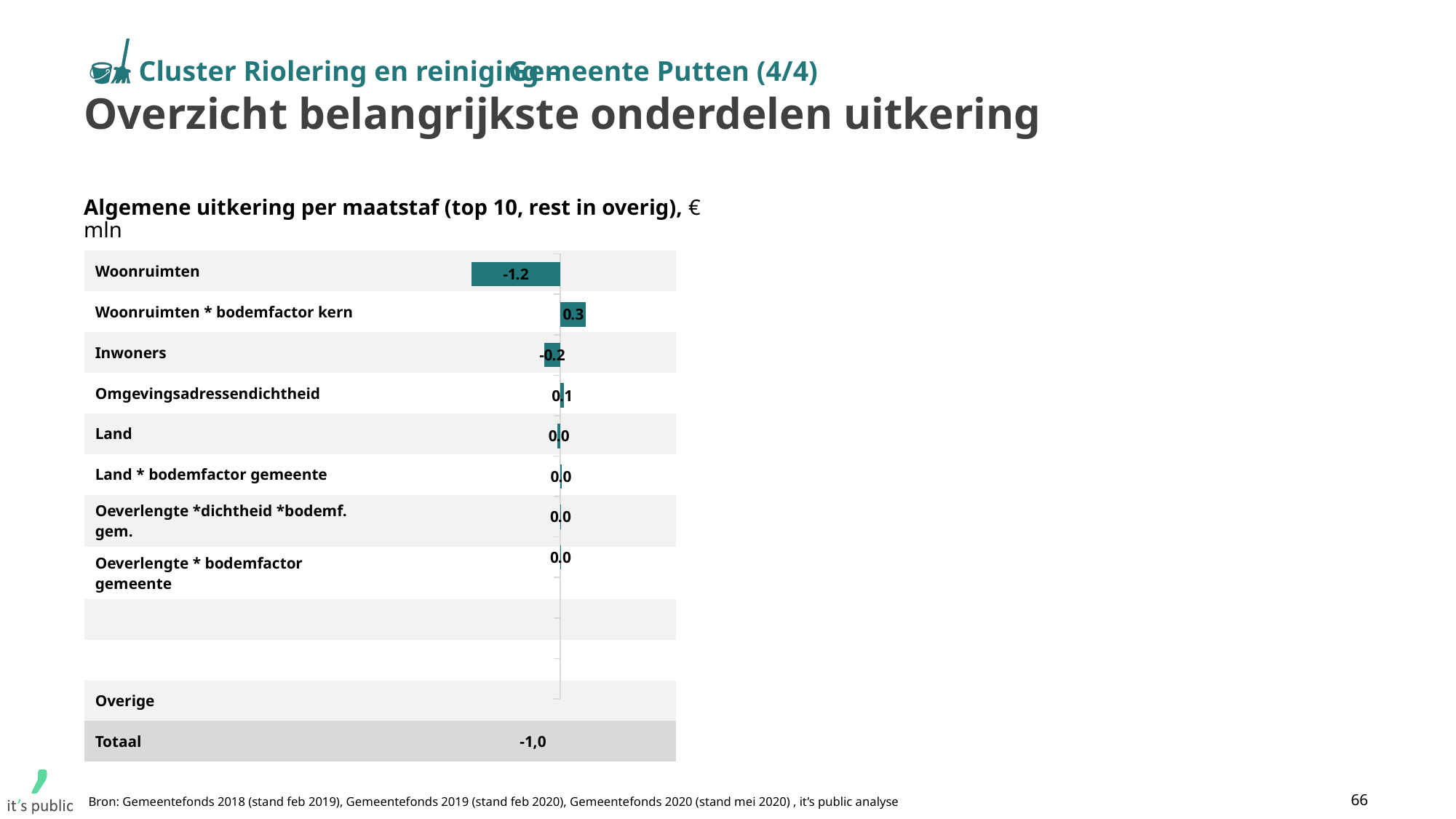
What is the value shown for Totaal? -1,0 What is the value for Woonruimten? -1.2 What is the value for Inwoners? -0.2 What kind of chart is shown on the slide? Bar chart How many categories have a value of 0.0? 4 What is the value for Omgevingsadressendichtheid? 0.1 Which category has the highest value? Woonruimten * bodemfactor kern Which is larger, the value for Omgevingsadressendichtheid or the value for Inwoners? Omgevingsadressendichtheid What is the difference between the values for Woonruimten * bodemfactor kern and Inwoners? 0.5 What is the title of the chart? Algemene uitkering per maatstaf (top 10, rest in overig), € mln What is the value for Woonruimten * bodemfactor kern? 0.3 Which category has the lowest (most negative) value? Woonruimten